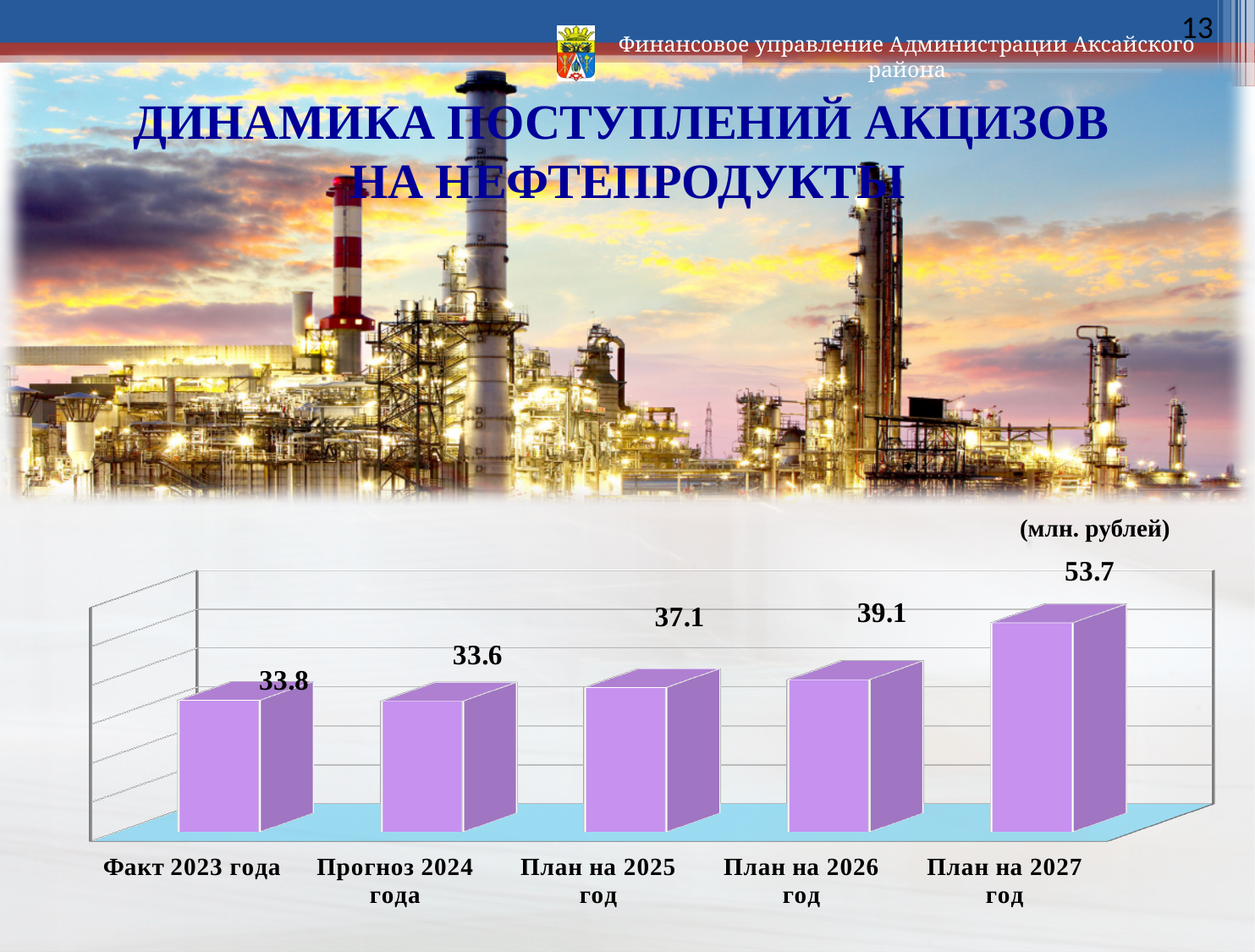
What is the value for Факт 2023 года? 33.8 What is the difference between the values for План на 2027 год and План на 2026 год? 14.6 Which category has the lowest value? Прогноз 2024 года What kind of chart is shown on the slide? bar chart What is the value for Прогноз 2024 года? 33.6 Which is larger, the value for План на 2026 год or the value for План на 2025 год? План на 2026 год How many categories are shown on the chart? 5 Which category has the highest value? План на 2027 год In what units are the chart values given? млн. рублей What is the difference between the values for План на 2025 год and Факт 2023 года? 3.3 What is the value for План на 2027 год? 53.7 What is the value for План на 2025 год? 37.1